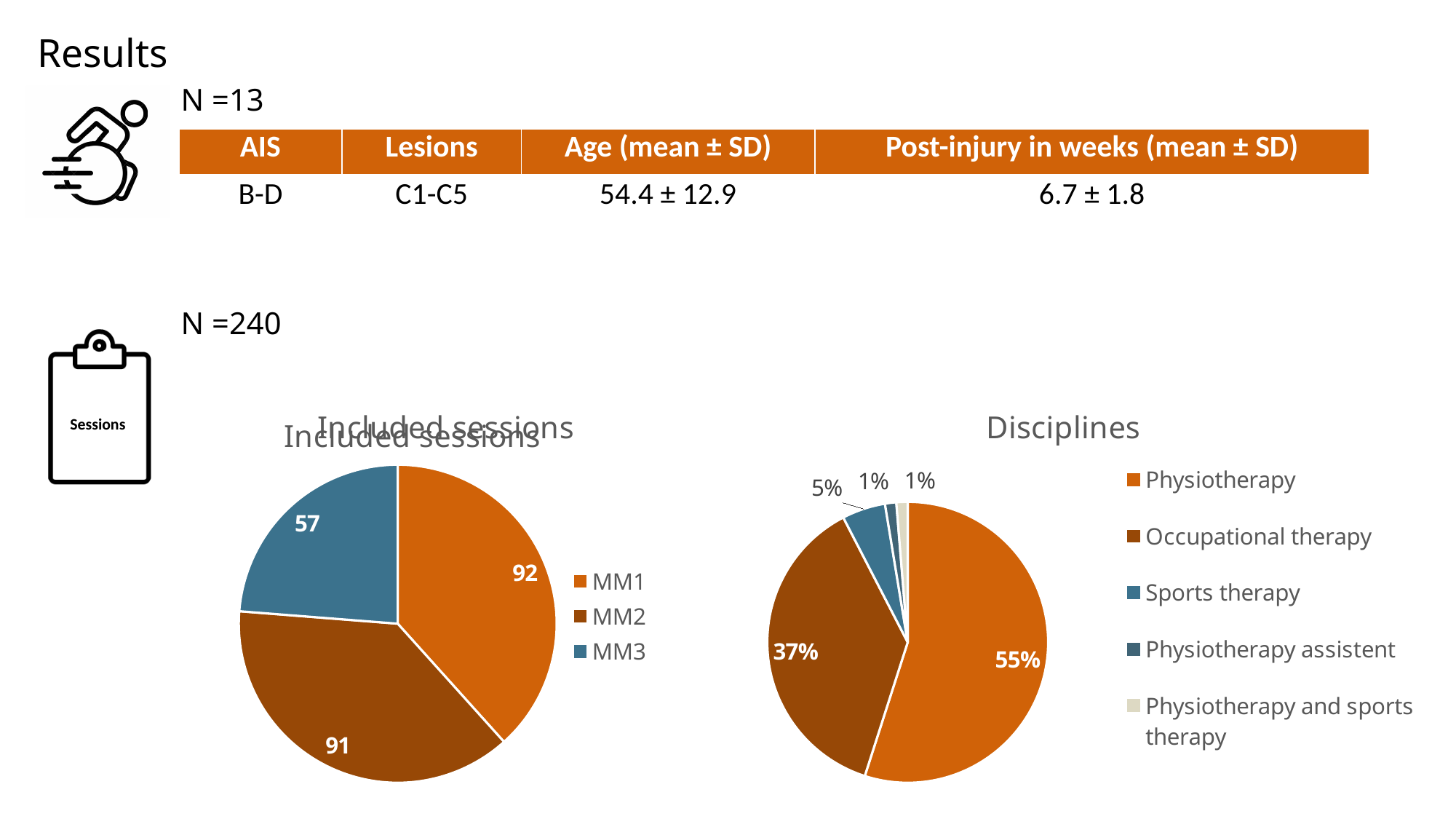
In the "Disciplines" chart, which discipline has the largest slice? Physiotherapy In the "Disciplines" chart, how many disciplines does the legend list? 5 In the "Disciplines" chart, what is the value for Sports therapy? 5% In the "Included sessions" chart, how many categories does the legend list? 3 In the "Included sessions" chart, what is the total of all three slices? 240 In the "Disciplines" chart, what share of the pie is Occupational therapy? 37% In the "Included sessions" chart, which category has the smallest slice? MM3 In the "Included sessions" chart, what is the difference between the values for MM2 and MM3? 34 In the "Included sessions" chart, what is the value for MM3? 57 What type of chart is the "Included sessions" chart? pie chart In the "Disciplines" chart, what share of the pie is Physiotherapy? 55% In the "Included sessions" chart, what is the value for MM1? 92